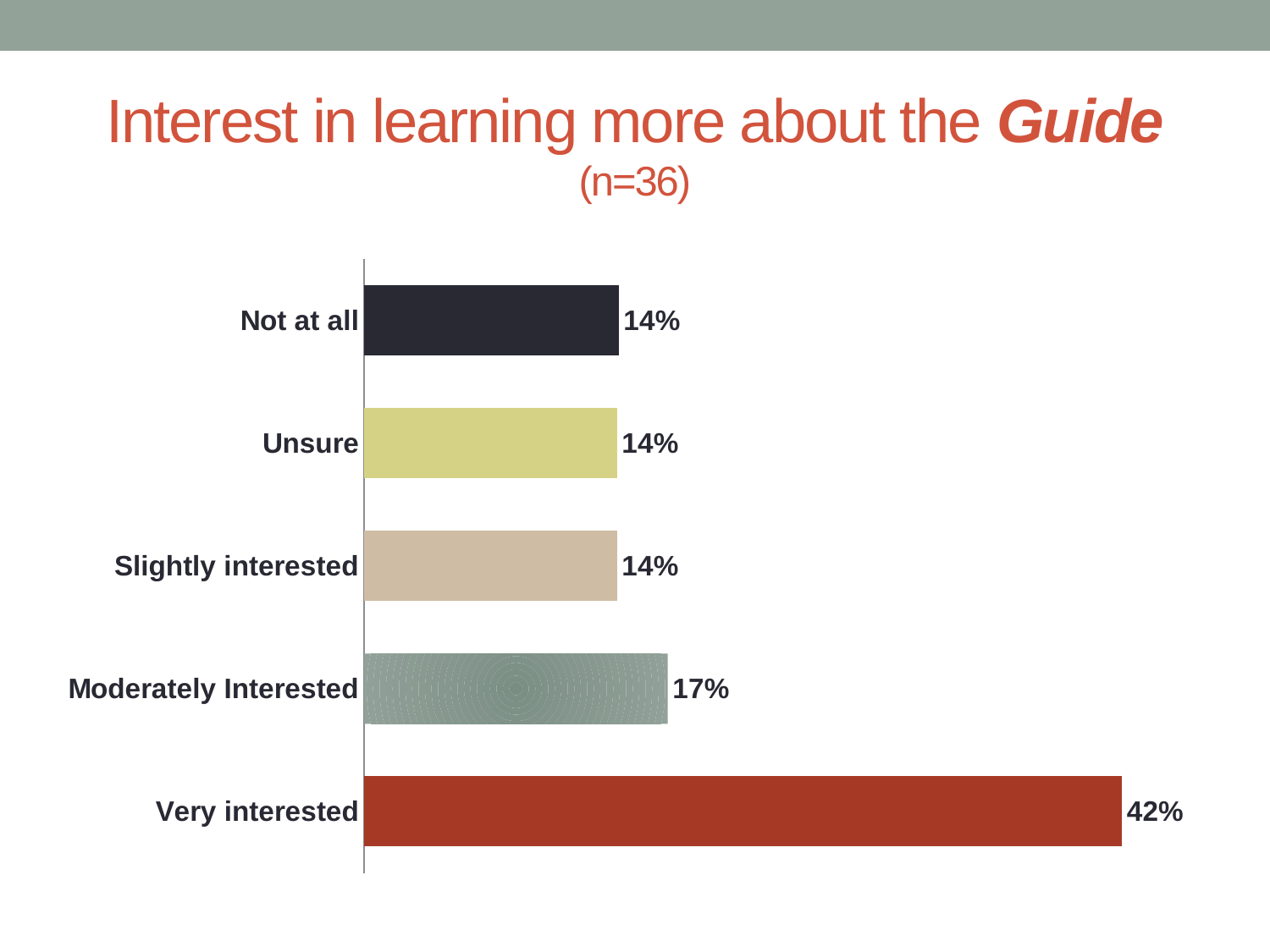
How many categories share the value 14%? 3 What kind of chart is shown on the slide? Bar chart What is the value for Not at all? 14% What is the difference between the Very interested and Moderately Interested values? 25% What is the difference between the Moderately Interested and Slightly interested values? 3% Which is larger, the value for Very interested or the value for Moderately Interested? Very interested What is the value for Unsure? 14% Which category has the highest value? Very interested What percentage of respondents are very interested in learning more about the Guide? 42% What sample size is given in the chart title? n=36 What is the value for Moderately Interested? 17% How many categories are shown in the chart? 5